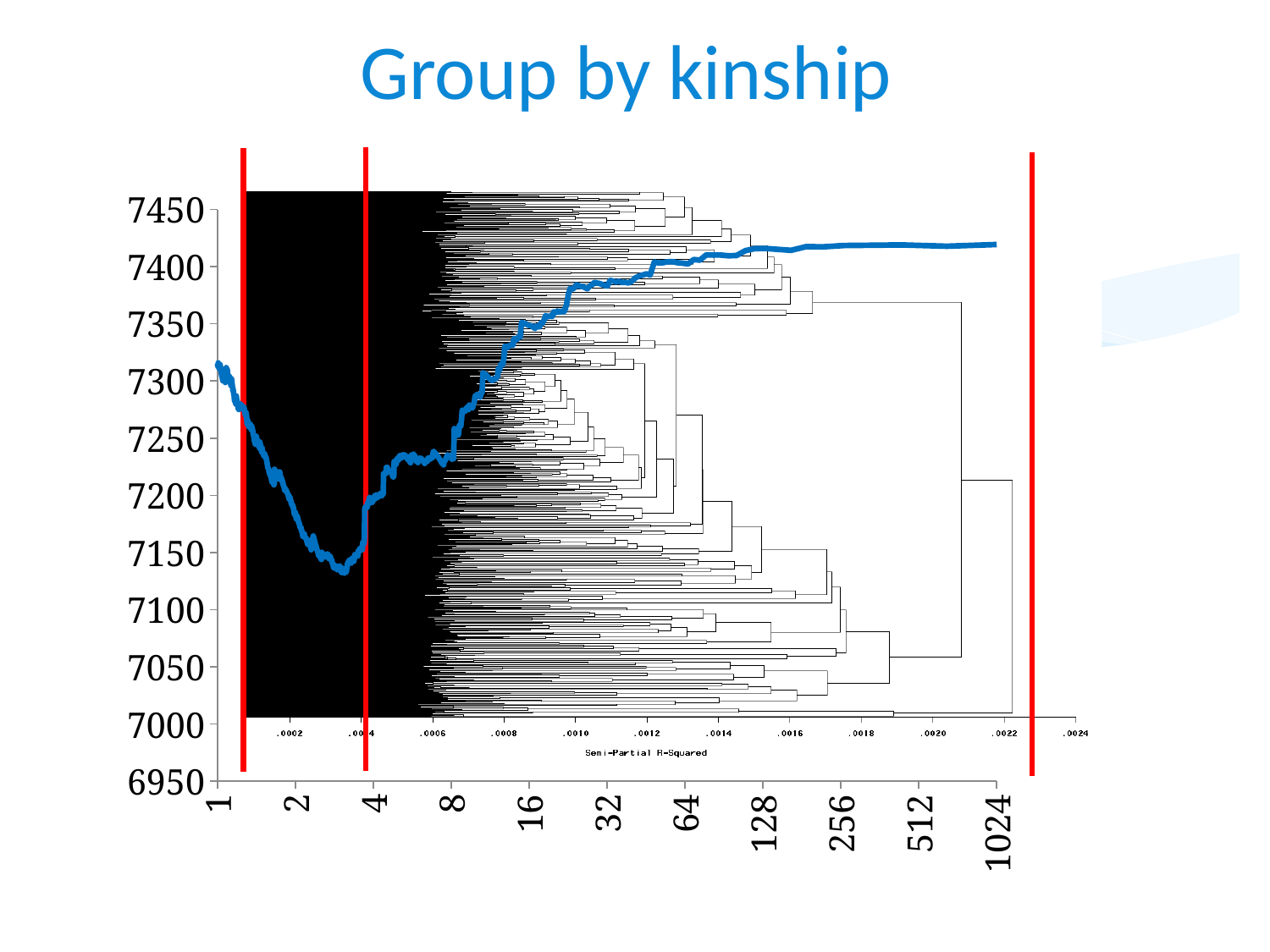
How many tick labels are shown on the x axis (1 through 1024)? 11 Which is larger, the value of the blue line at x = 1 or at x = 1024? x = 1024 What is the highest value labelled on the y axis? 7450 Is the value of the blue line at x = 8 greater or less than 7200? greater Is the value of the blue line at x = 1024 greater or less than 7400? greater What kind of chart is the blue series plotted as? line chart Is the lowest point of the blue line greater or less than 7150? less Between which two x-axis tick labels does the blue line reach its lowest point? 2 and 4 What is the title of the slide's chart? Group by kinship Does the blue line rise or fall between x = 8 and x = 128? rise